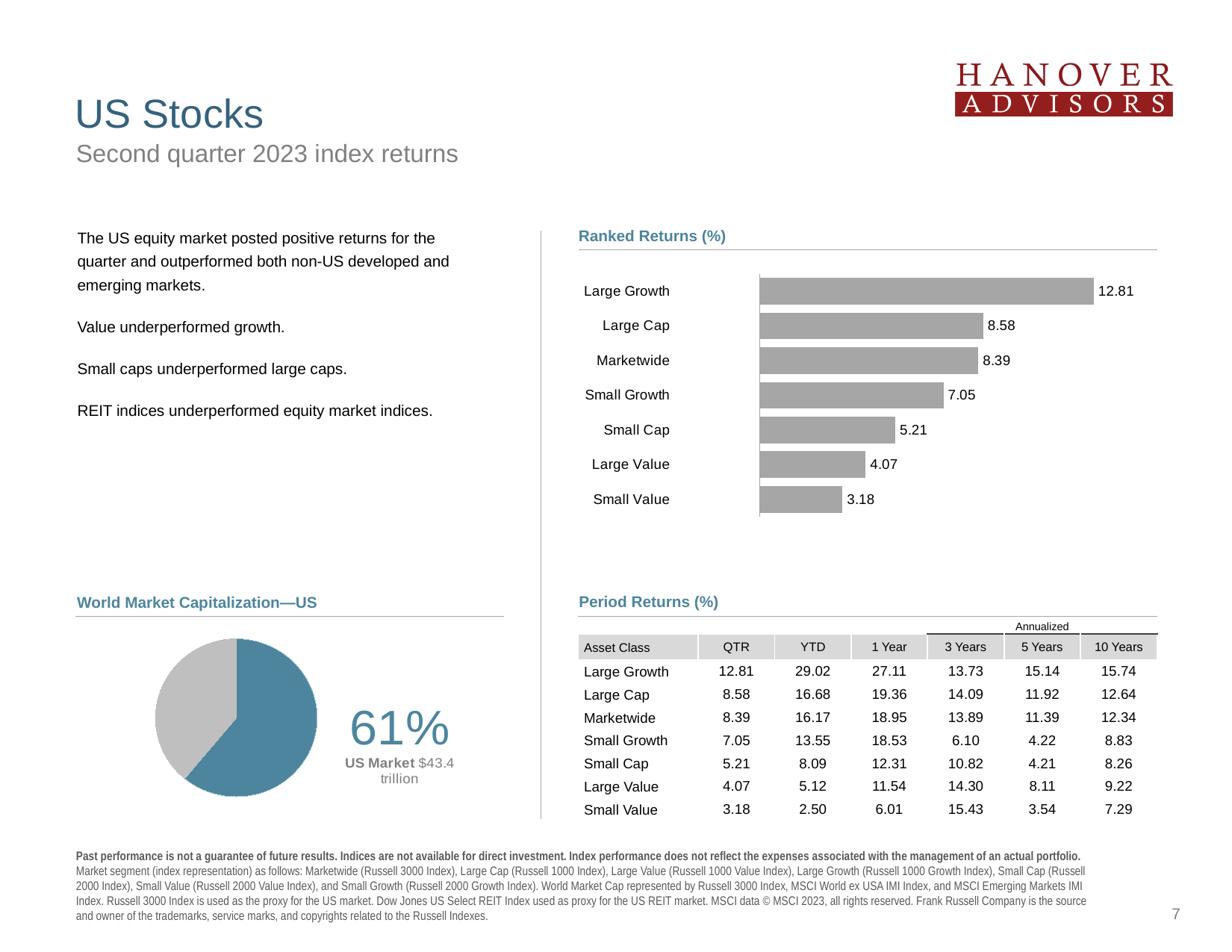
How many categories are shown in the Ranked Returns (%) chart? 7 In the Ranked Returns (%) chart, what is the difference between Large Cap and Marketwide? 0.19 In the Ranked Returns (%) chart, which is larger, Small Growth or Large Value? Small Growth What kind of chart is the World Market Capitalization—US chart? Pie chart In the World Market Capitalization—US chart, what is the US market value shown below the percentage? $43.4 trillion In the World Market Capitalization—US chart, what share of the pie does the US market represent? 61% In the Ranked Returns (%) chart, what is the value for Large Growth? 12.81 In the Ranked Returns (%) chart, which category has the highest value? Large Growth In the Ranked Returns (%) chart, which category has the lowest value? Small Value In the Ranked Returns (%) chart, what is the value for Small Cap? 5.21 What kind of chart is the Ranked Returns (%) chart? Bar chart In the Ranked Returns (%) chart, what is the difference between Large Growth and Small Value? 9.63